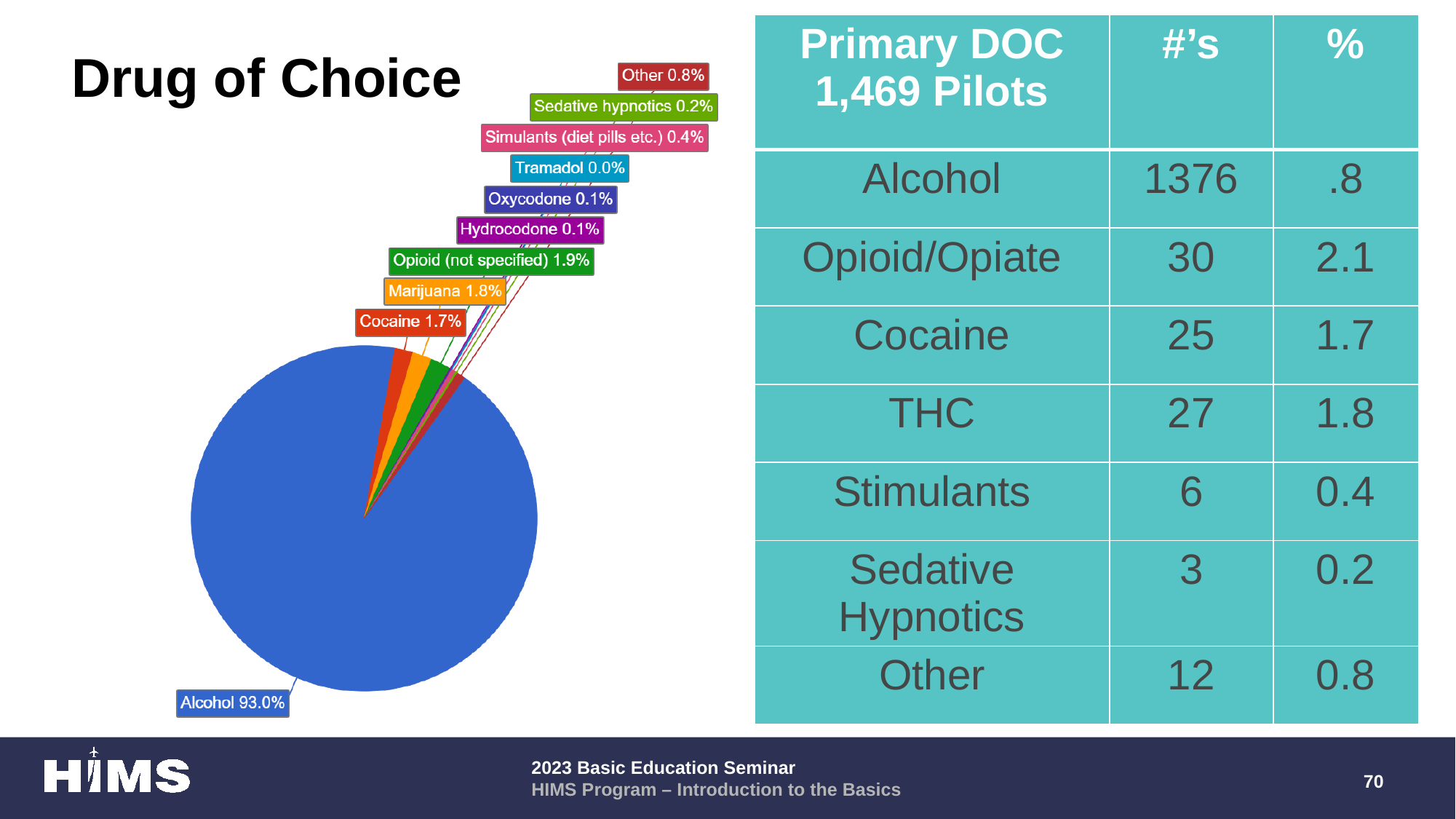
What share of the pie does Alcohol represent? 93.0% Which category has the smallest labelled share in the pie chart? Tramadol What percentage is shown for Opioid (not specified) in the pie chart? 1.9% What percentage is shown for Marijuana in the pie chart? 1.8% Which category has the largest slice of the pie chart? Alcohol What is the title of the slide containing the pie chart? Drug of Choice What kind of chart is shown on the slide? pie chart Which has a larger share in the pie chart, Marijuana or Cocaine? Marijuana How many slices are labelled in the pie chart? 10 What is the difference between the Opioid (not specified) share and the Cocaine share in the pie chart? 0.2% What percentage is shown for Cocaine in the pie chart? 1.7% What percentage is shown for Other in the pie chart? 0.8%